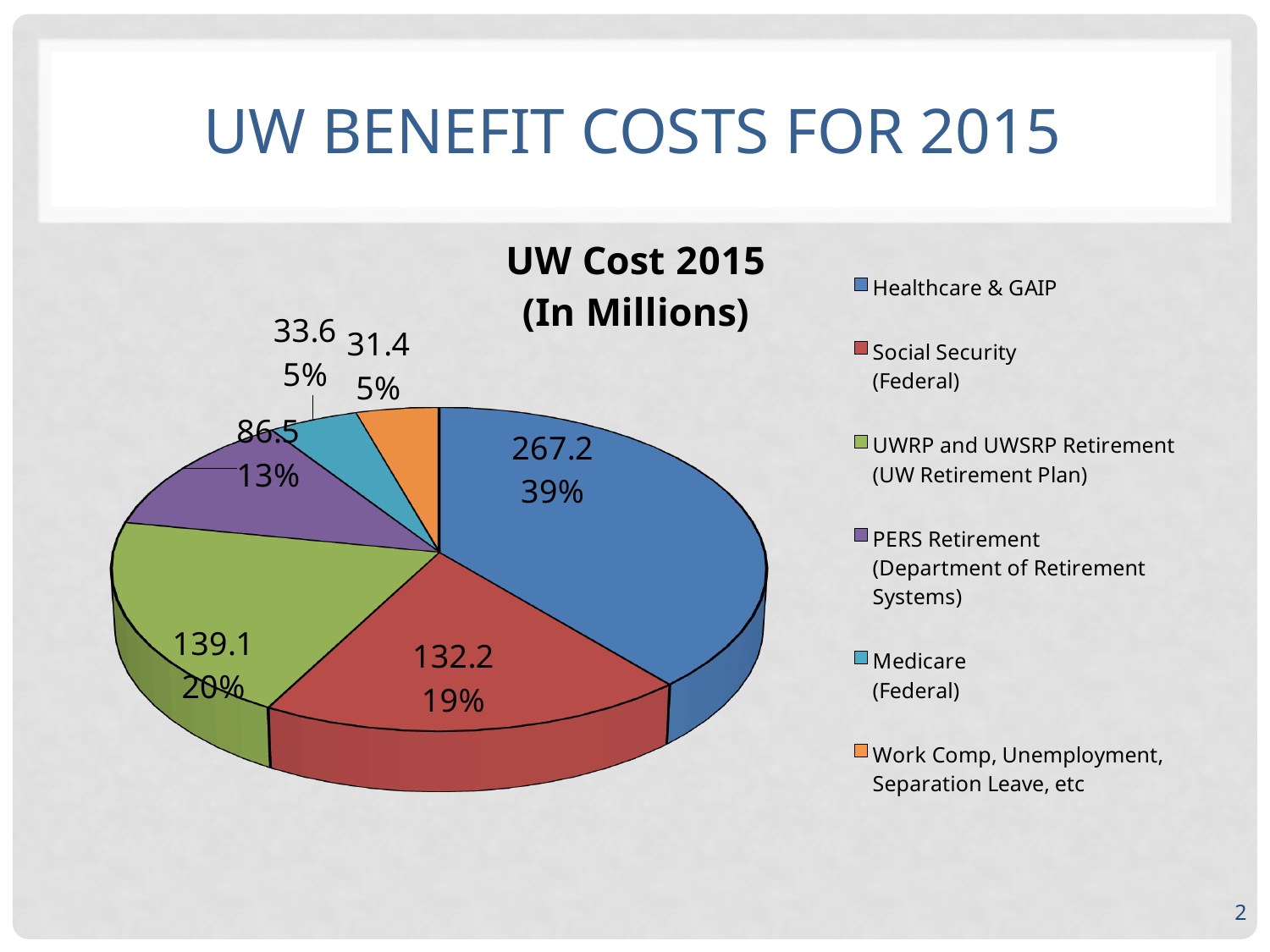
What is the value for UWRP and UWSRP Retirement? 139.1 What is the title of the chart? UW Cost 2015 (In Millions) What share of the pie does Healthcare & GAIP represent? 39% Which category has the largest slice of the pie? Healthcare & GAIP What is the value for Social Security (Federal)? 132.2 What is the value for PERS Retirement? 86.5 How many categories does the legend list? 6 What is the value for Healthcare & GAIP? 267.2 What share of the pie does PERS Retirement represent? 13% What kind of chart is shown on the slide? pie chart What is the difference between the values for Healthcare & GAIP and Social Security (Federal)? 135 Which is larger, the value for UWRP and UWSRP Retirement or the value for Social Security (Federal)? UWRP and UWSRP Retirement